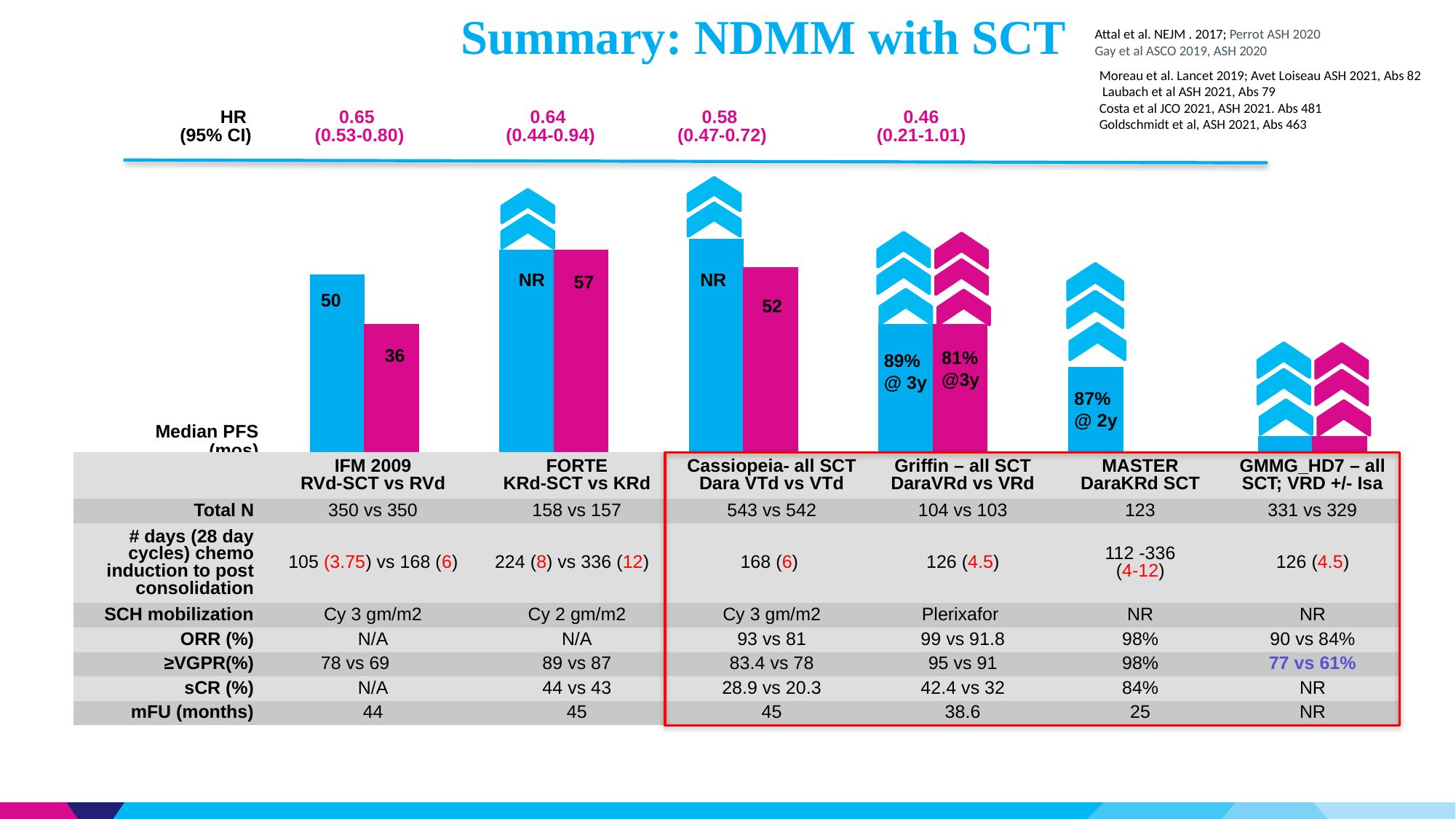
In the Median PFS bar chart, what is the median PFS (months) for the KRd arm of FORTE? 57 How many trials are shown along the x axis of the Median PFS bar chart? 6 In the Median PFS bar chart, what value is shown for the KRd-SCT arm of FORTE? NR In the Median PFS bar chart, which has the higher median PFS: the KRd arm of FORTE or the VTd arm of Cassiopeia? KRd arm of FORTE In the Median PFS bar chart, what is the median PFS (months) for the VTd arm of Cassiopeia? 52 In the Median PFS bar chart, what is the median PFS (months) for the RVd arm of IFM 2009? 36 In the Median PFS bar chart, what PFS rate is shown for the VRd arm of Griffin? 81% @3y In the Median PFS bar chart, what is the median PFS (months) for the RVd-SCT arm of IFM 2009? 50 In the Median PFS bar chart, what PFS rate is shown for the DaraVRd arm of Griffin? 89% @ 3y In the Median PFS bar chart, what PFS rate is shown for MASTER (DaraKRd SCT)? 87% @ 2y In the Median PFS bar chart, what is the difference in median PFS between the RVd-SCT and RVd arms of IFM 2009? 14 What kind of chart is used to show Median PFS on the slide? bar chart